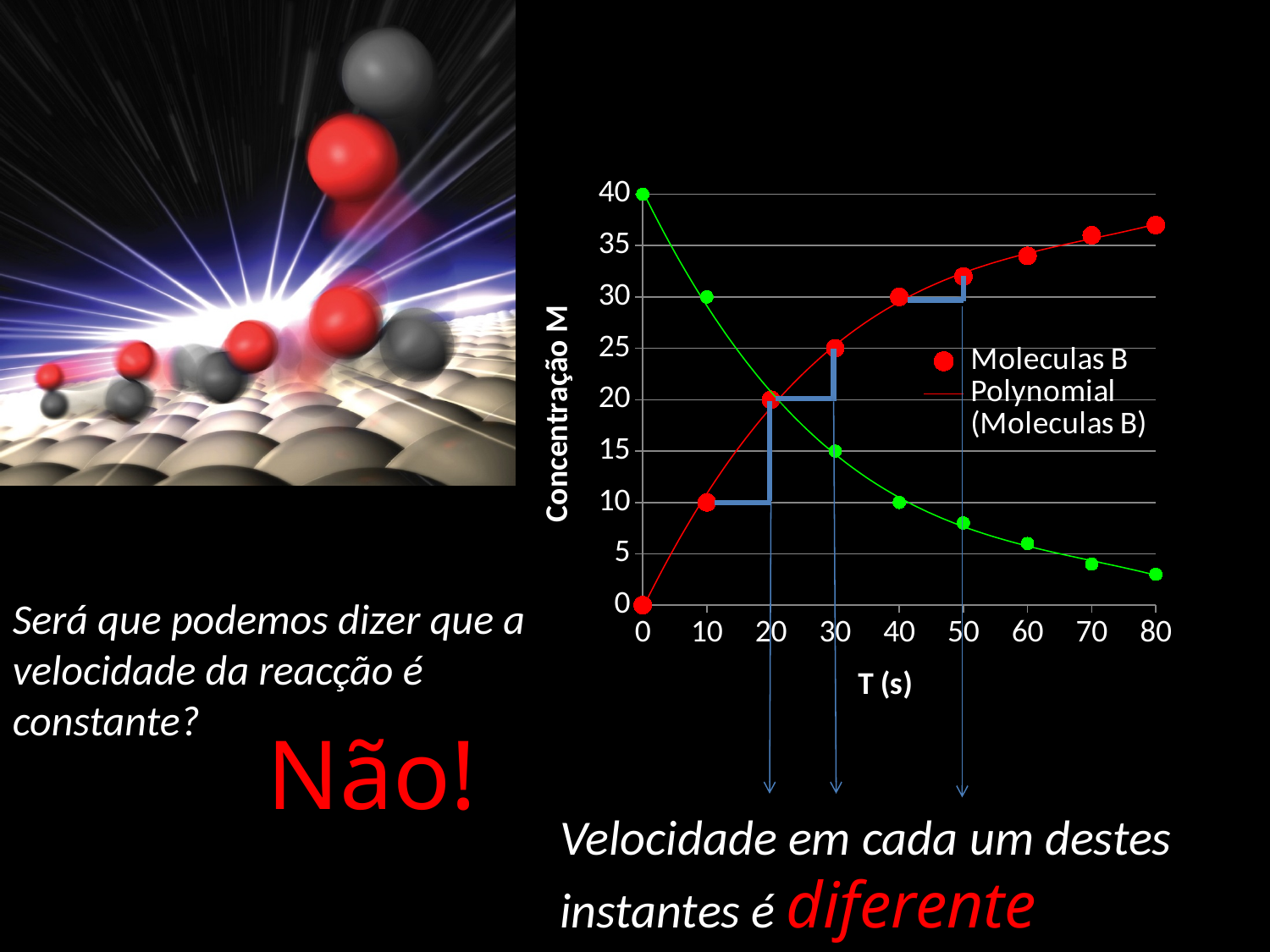
What is the value of the green series at T = 30 s? 15 What is the value of the green series at T = 0 s? 40 What is the title of the vertical axis? Concentração M Is the value of the Moleculas B series at T = 80 s greater or less than 35? greater What is the value of the Moleculas B series at T = 30 s? 25 Do the values of the green series rise or fall as T increases? Fall What kind of chart is shown on the slide? Scatter chart with lines What is the value of the Moleculas B series at T = 40 s? 30 What is the difference between the Moleculas B value at T = 40 s and at T = 10 s? 20 What is the value of the Moleculas B series at T = 20 s? 20 Is the value of the green series at T = 80 s greater or less than 5? less Do the values of the Moleculas B (red) series rise or fall as T increases? Rise